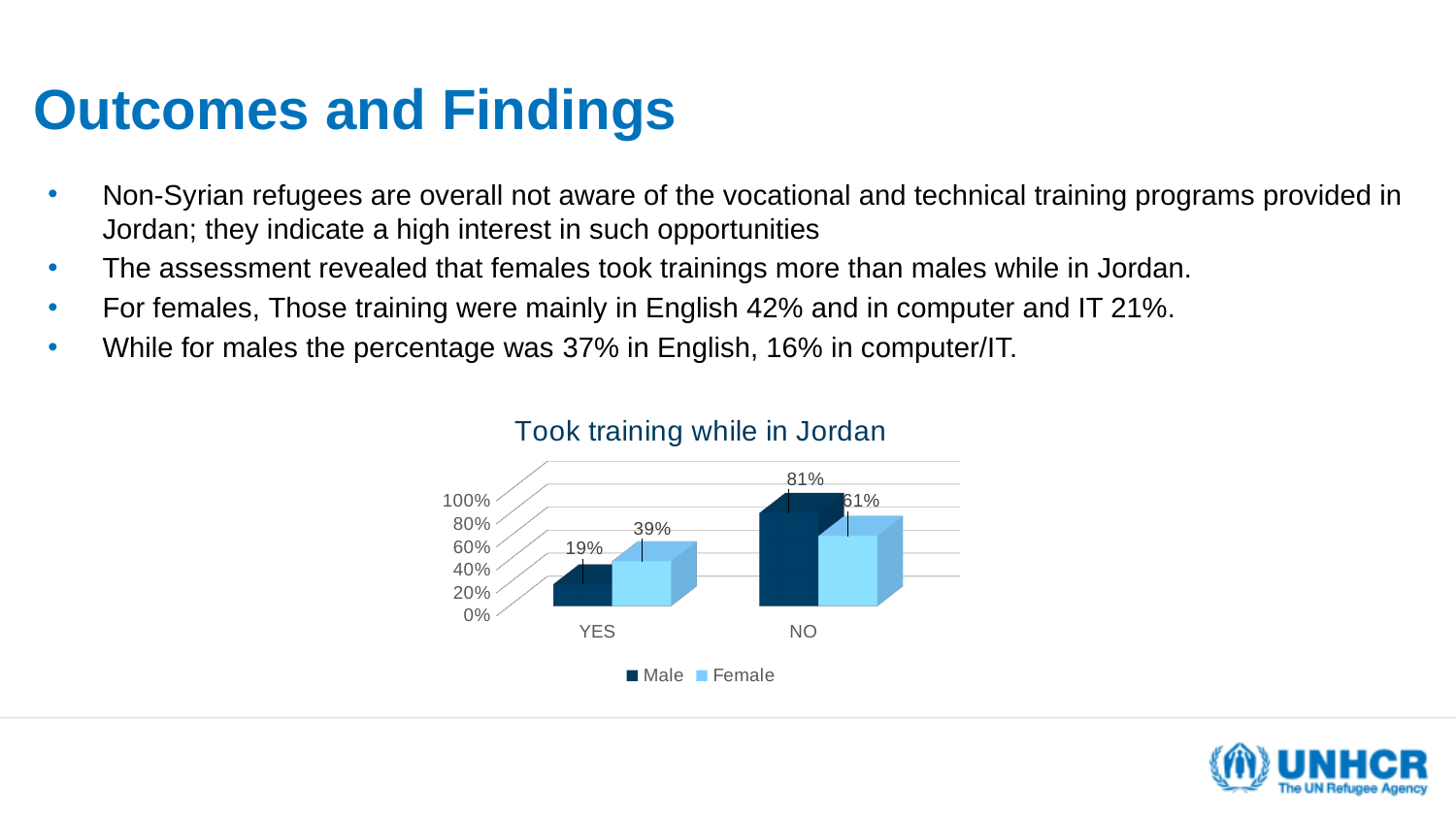
Which series has the higher value in the YES category, Male or Female? Female What is the value for Male in the NO category? 81% What is the title of the chart? Took training while in Jordan What is the difference between the Male and Female values in the NO category? 20% What is the value for Female in the YES category? 39% What is the value for Female in the NO category? 61% How many series does the legend list? 2 How many categories are shown on the x axis? 2 What is the value for Male in the YES category? 19% What type of chart is shown on the slide? Bar chart Which bar has the lowest value in the chart? Male, YES Which bar has the highest value in the chart? Male, NO